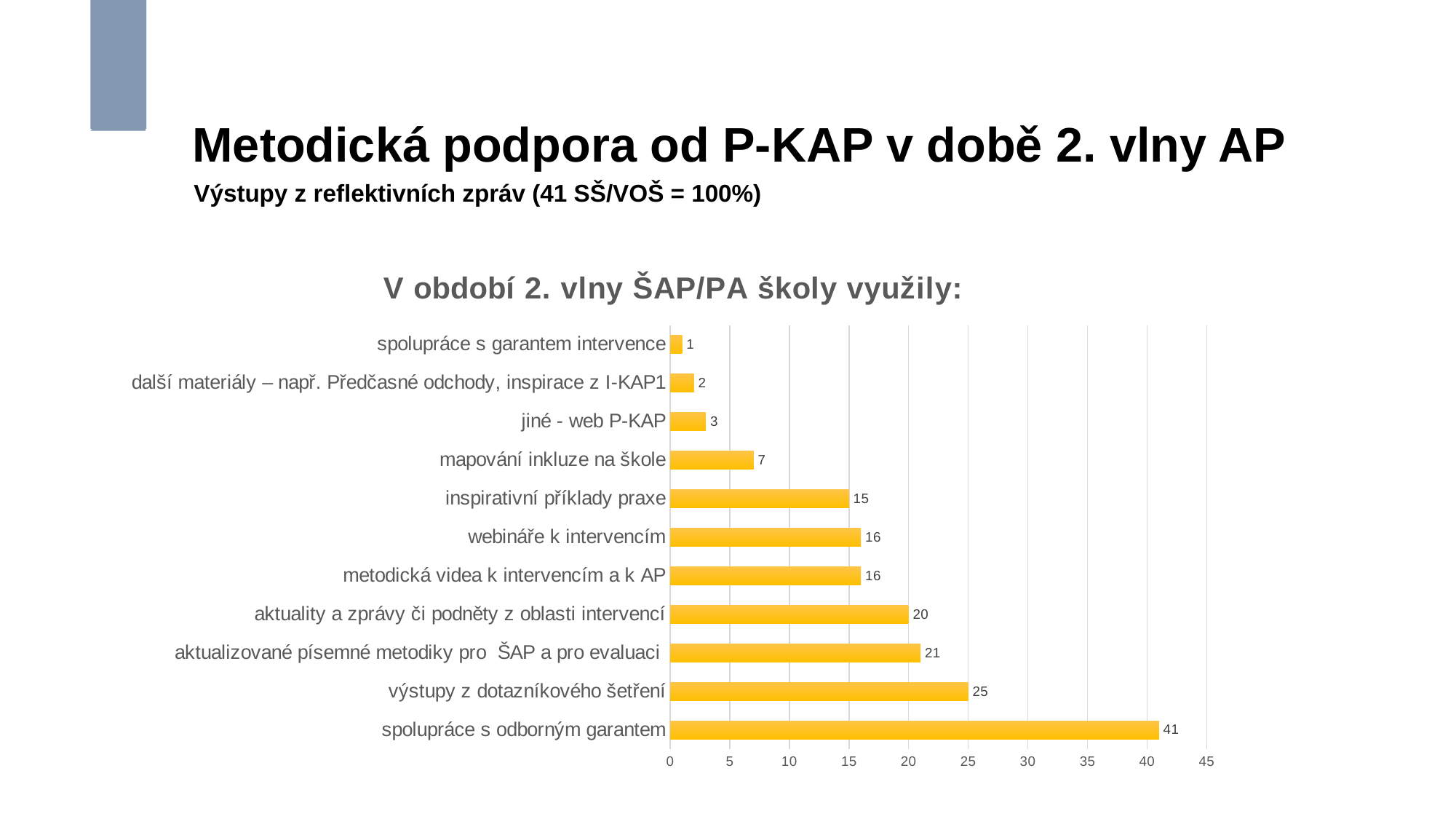
What is the title of the chart? V období 2. vlny ŠAP/PA školy využily: What is the difference between the values for "spolupráce s odborným garantem" and "výstupy z dotazníkového šetření"? 16 What is the value for "výstupy z dotazníkového šetření"? 25 Which category has the lowest value? spolupráce s garantem intervence Which category has the highest value? spolupráce s odborným garantem What kind of chart is shown on the slide? bar chart What is the value for "mapování inkluze na škole"? 7 How many categories are shown in the chart? 11 What is the value for "jiné - web P-KAP"? 3 Which is larger, the value for "aktuality a zprávy či podněty z oblasti intervencí" or the value for "inspirativní příklady praxe"? aktuality a zprávy či podněty z oblasti intervencí Is the value for "aktualizované písemné metodiky pro ŠAP a pro evaluaci" greater or less than 20? greater What is the value for "spolupráce s odborným garantem"? 41